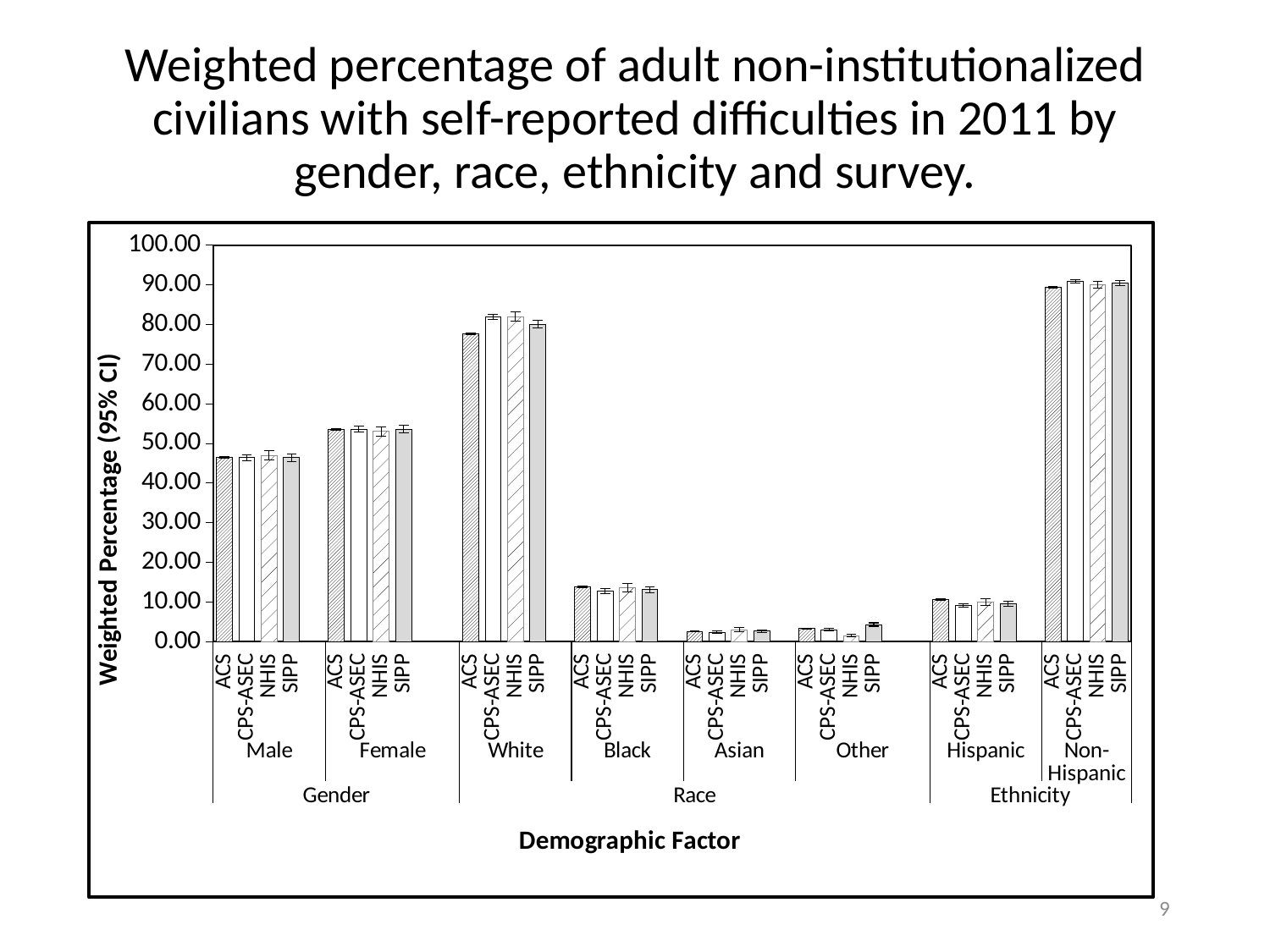
Which demographic group has the highest bars in the chart? Non-Hispanic Is the ACS value for Male greater or less than 50.00? less What is the title of the y axis? Weighted Percentage (95% CI) How many demographic groups (e.g. Male, Female, White) are shown along the x axis? 8 Is the ACS value for Female greater or less than 50.00? greater Which is larger, the ACS value for Hispanic or the ACS value for Non-Hispanic? Non-Hispanic Is the ACS value for White greater or less than 70.00? greater Which race category has the highest values? White What kind of chart is shown on the slide? bar chart How many surveys are plotted for each demographic group? 4